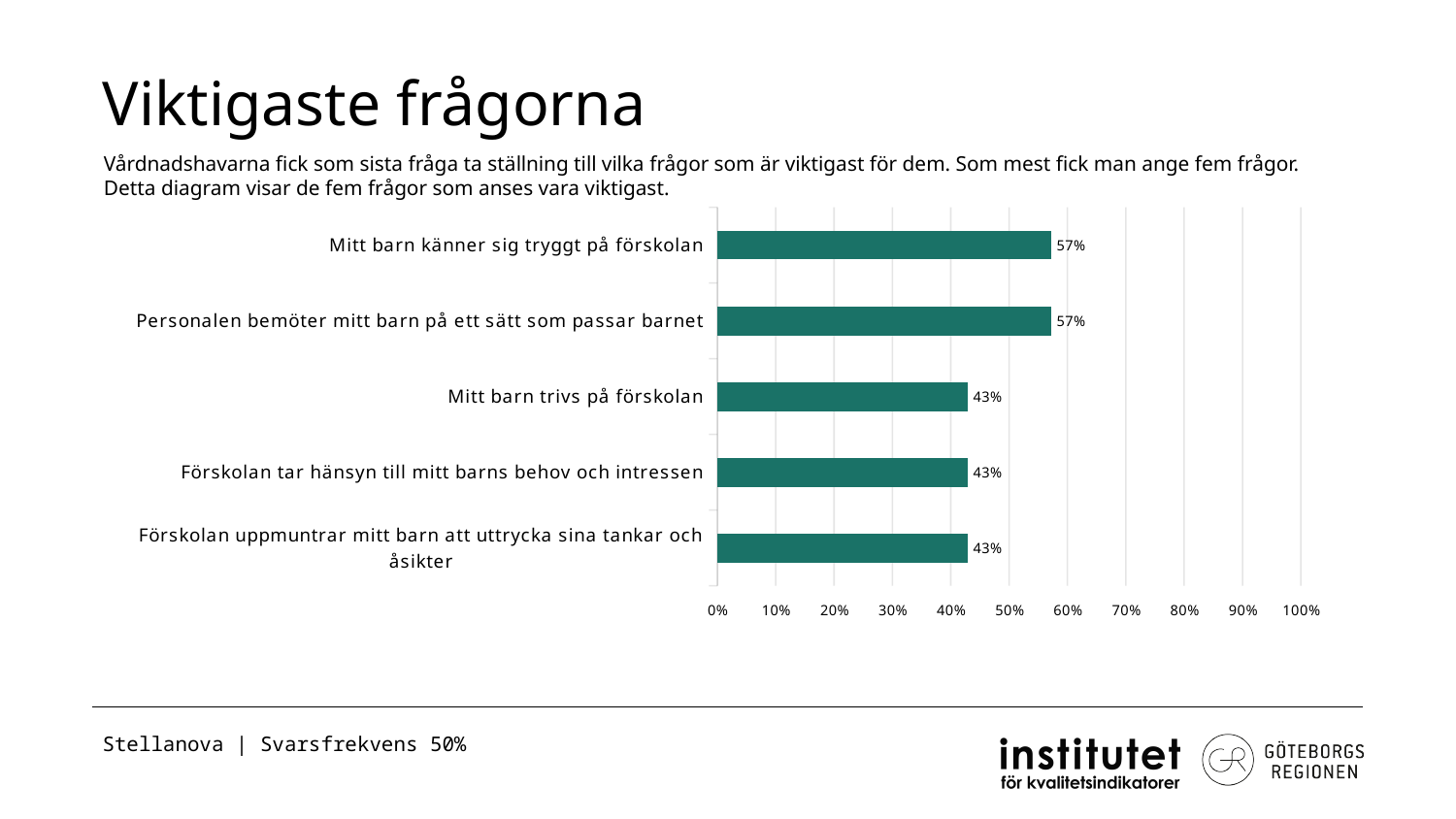
What kind of chart is shown on the slide? bar chart Is the value for "Mitt barn trivs på förskolan" greater or less than 50%? less What is the value for "Förskolan tar hänsyn till mitt barns behov och intressen"? 43% Which is larger: the value for "Mitt barn känner sig tryggt på förskolan" or the value for "Mitt barn trivs på förskolan"? Mitt barn känner sig tryggt på förskolan What is the value for "Förskolan uppmuntrar mitt barn att uttrycka sina tankar och åsikter"? 43% How many categories are plotted in the chart? 5 What is the value for "Personalen bemöter mitt barn på ett sätt som passar barnet"? 57% What is the highest value shown in the chart? 57% What is the value for "Mitt barn trivs på förskolan"? 43% What is the value for "Mitt barn känner sig tryggt på förskolan"? 57% What is the difference between the value for "Personalen bemöter mitt barn på ett sätt som passar barnet" and the value for "Förskolan tar hänsyn till mitt barns behov och intressen"? 14 percentage points What is the lowest value shown in the chart? 43%